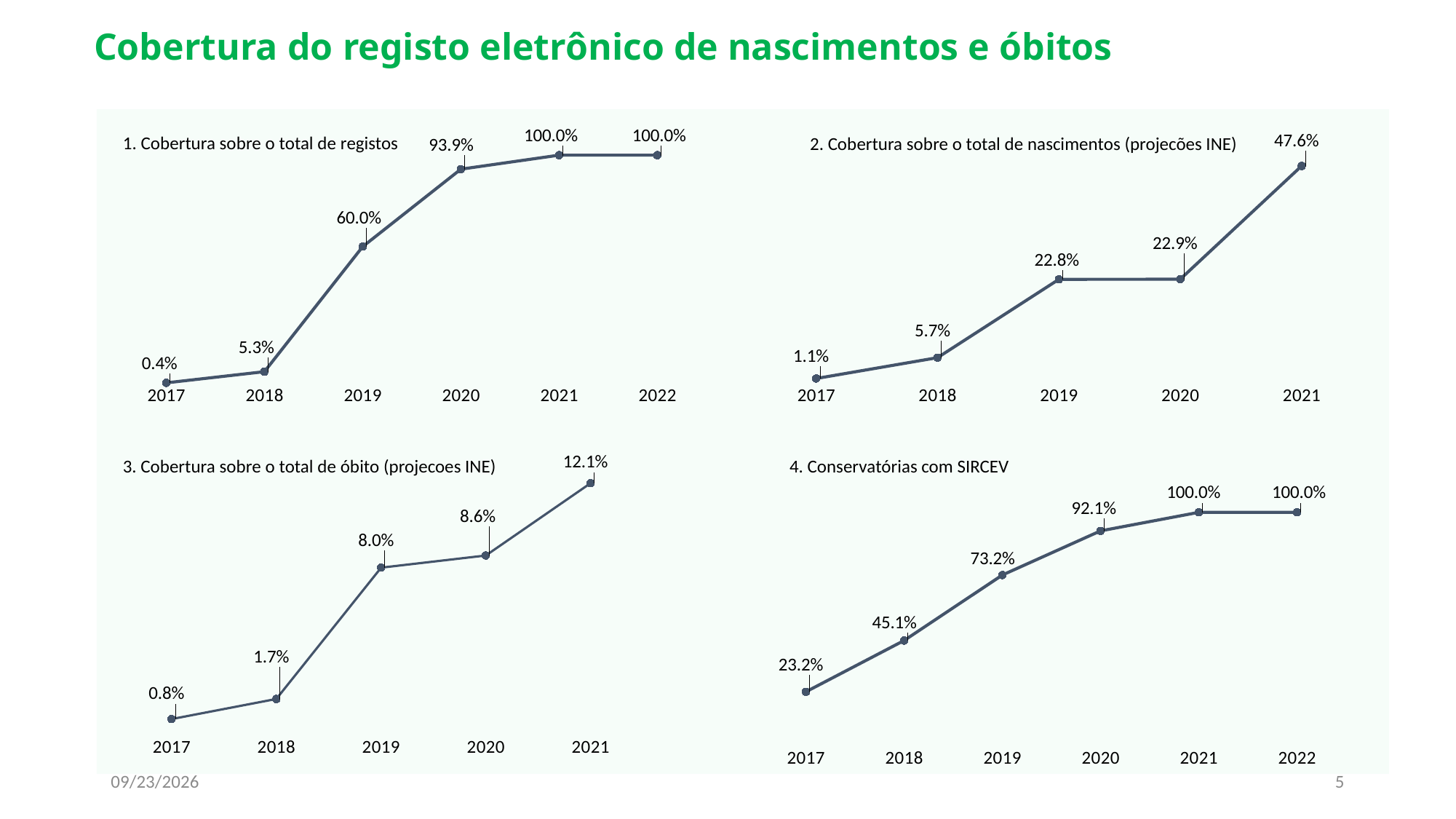
What kind of chart is '4. Conservatórias com SIRCEV'? Line chart In the chart '1. Cobertura sobre o total de registos', what is the difference between the 2020 and 2019 values? 33.9% In the chart '1. Cobertura sobre o total de registos', do the values rise or fall from 2017 to 2022? Rise In the chart '1. Cobertura sobre o total de registos', what is the value for 2019? 60.0% In the chart '2. Cobertura sobre o total de nascimentos (projecões INE)', which year has the lowest value? 2017 In the chart '4. Conservatórias com SIRCEV', what is the value for 2018? 45.1% In the chart '2. Cobertura sobre o total de nascimentos (projecões INE)', which is larger, the value for 2019 or the value for 2021? 2021 How many years are plotted in the chart '3. Cobertura sobre o total de óbito (projecoes INE)'? 5 In the chart '3. Cobertura sobre o total de óbito (projecoes INE)', what is the value for 2020? 8.6% In the chart '3. Cobertura sobre o total de óbito (projecoes INE)', which year has the highest value? 2021 In the chart '2. Cobertura sobre o total de nascimentos (projecões INE)', what is the value for 2021? 47.6% In the chart '4. Conservatórias com SIRCEV', what is the difference between the 2019 and 2018 values? 28.1%